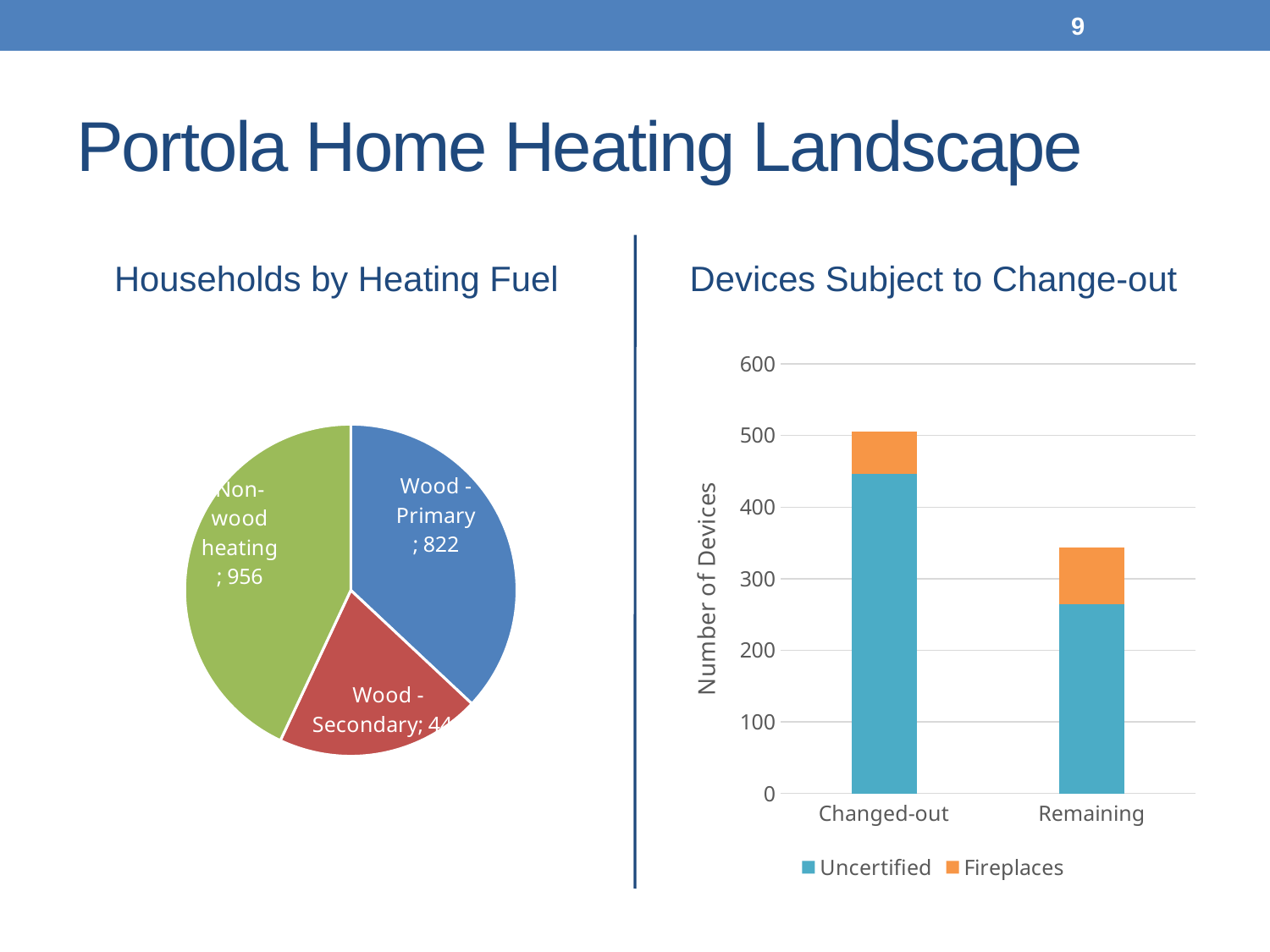
What kind of chart is the Households by Heating Fuel chart? Pie chart In the Devices Subject to Change-out chart, which bar is taller overall, Changed-out or Remaining? Changed-out In the Households by Heating Fuel pie chart, what is the difference between Non-wood heating and Wood - Primary? 134 In the Households by Heating Fuel chart, how many slices does the pie have? 3 In the Households by Heating Fuel pie chart, what is the value for Non-wood heating? 956 In the Households by Heating Fuel pie chart, which category has the smallest slice? Wood - Secondary What kind of chart is the Devices Subject to Change-out chart? Stacked bar chart In the Households by Heating Fuel pie chart, which category has the largest slice? Non-wood heating In the Devices Subject to Change-out chart, how many series does the legend list? 2 In the Households by Heating Fuel pie chart, how many households use Wood - Primary heating? 822 In the Devices Subject to Change-out chart, is the total for Changed-out greater or less than 400? greater In the Devices Subject to Change-out chart, is the Uncertified value for Remaining greater or less than 300? less